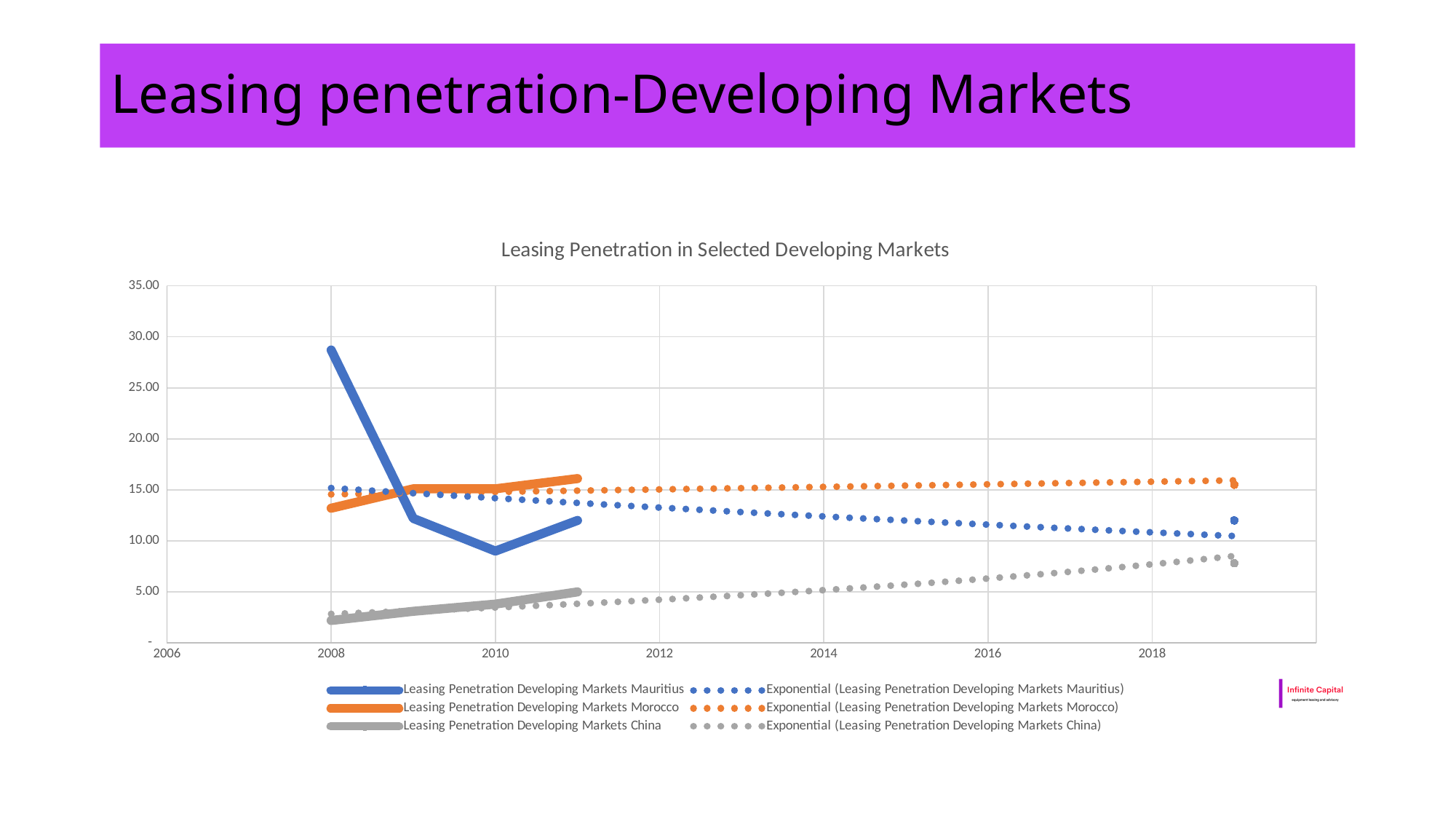
How many series does the legend list? 6 Is the value for Leasing Penetration Developing Markets Mauritius in 2010 greater or less than 10.00? less Does the Leasing Penetration Developing Markets China series rise or fall from 2008 to 2011? Rise Which colour is used for the Leasing Penetration Developing Markets China series? Grey What kind of chart is shown on the slide? Line chart Is the value for Leasing Penetration Developing Markets China in 2008 greater or less than 5.00? less In 2010, which is larger: Leasing Penetration Developing Markets Morocco or Leasing Penetration Developing Markets China? Leasing Penetration Developing Markets Morocco In 2008, which is larger: Leasing Penetration Developing Markets Mauritius or Leasing Penetration Developing Markets Morocco? Leasing Penetration Developing Markets Mauritius Is the value for Leasing Penetration Developing Markets Mauritius in 2008 greater or less than 25.00? greater Which series has the highest value in 2008? Leasing Penetration Developing Markets Mauritius What is the title of the chart? Leasing Penetration in Selected Developing Markets